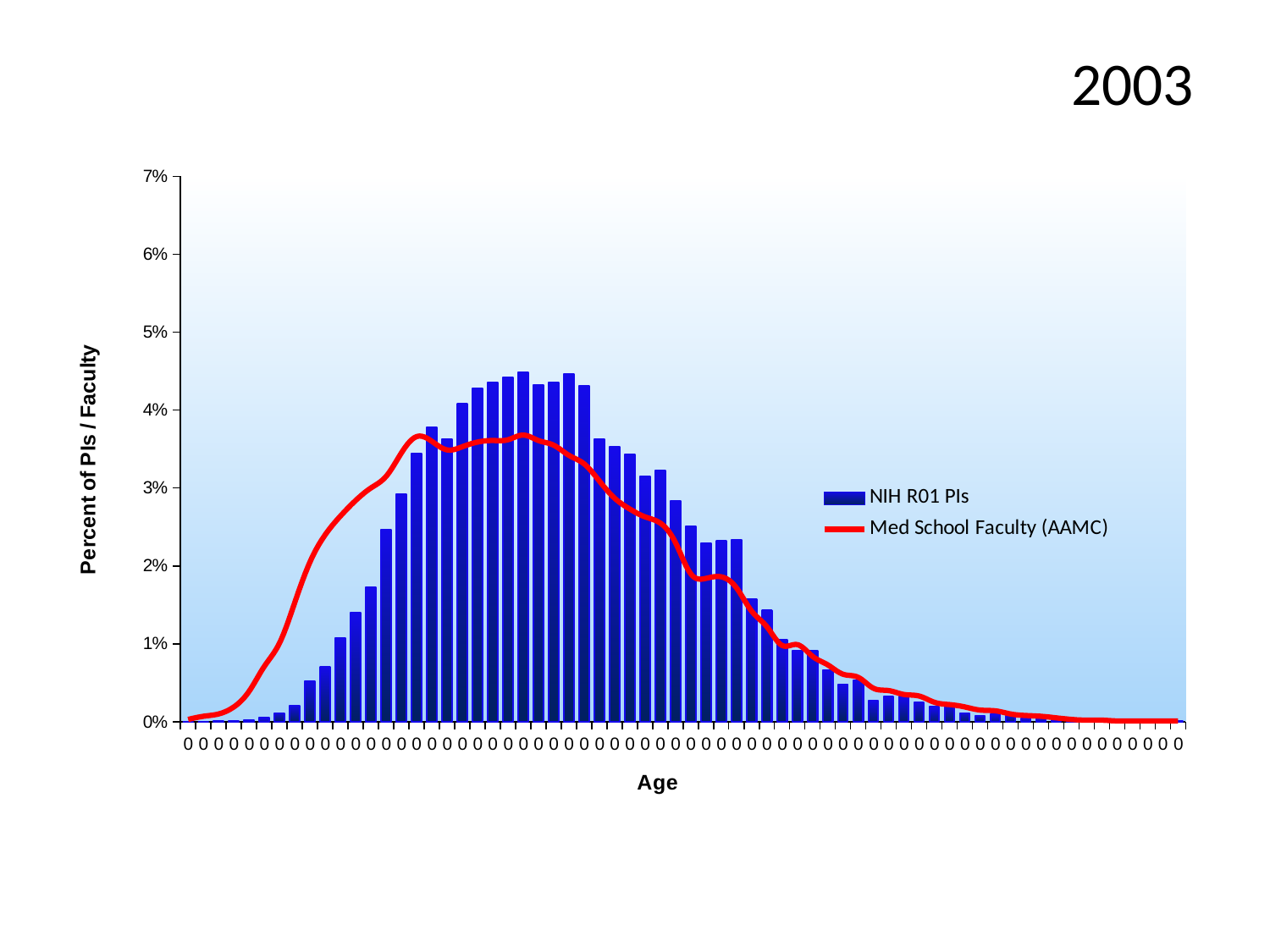
What year is shown as the slide title? 2003 What kind of chart is shown on the slide? A bar chart with a line overlay How many series does the legend list? 2 What is the title of the x axis? Age Is the value of the tallest NIH R01 PIs bar greater or less than 5%? less Which series is drawn as a red line? Med School Faculty (AAMC) Which series is drawn as blue bars? NIH R01 PIs Is the peak of the Med School Faculty (AAMC) line greater or less than 3%? greater Is the peak of the Med School Faculty (AAMC) line greater or less than 4%? less Which reaches a higher peak value: the NIH R01 PIs bars or the Med School Faculty (AAMC) line? NIH R01 PIs What is the title of the y axis? Percent of PIs / Faculty